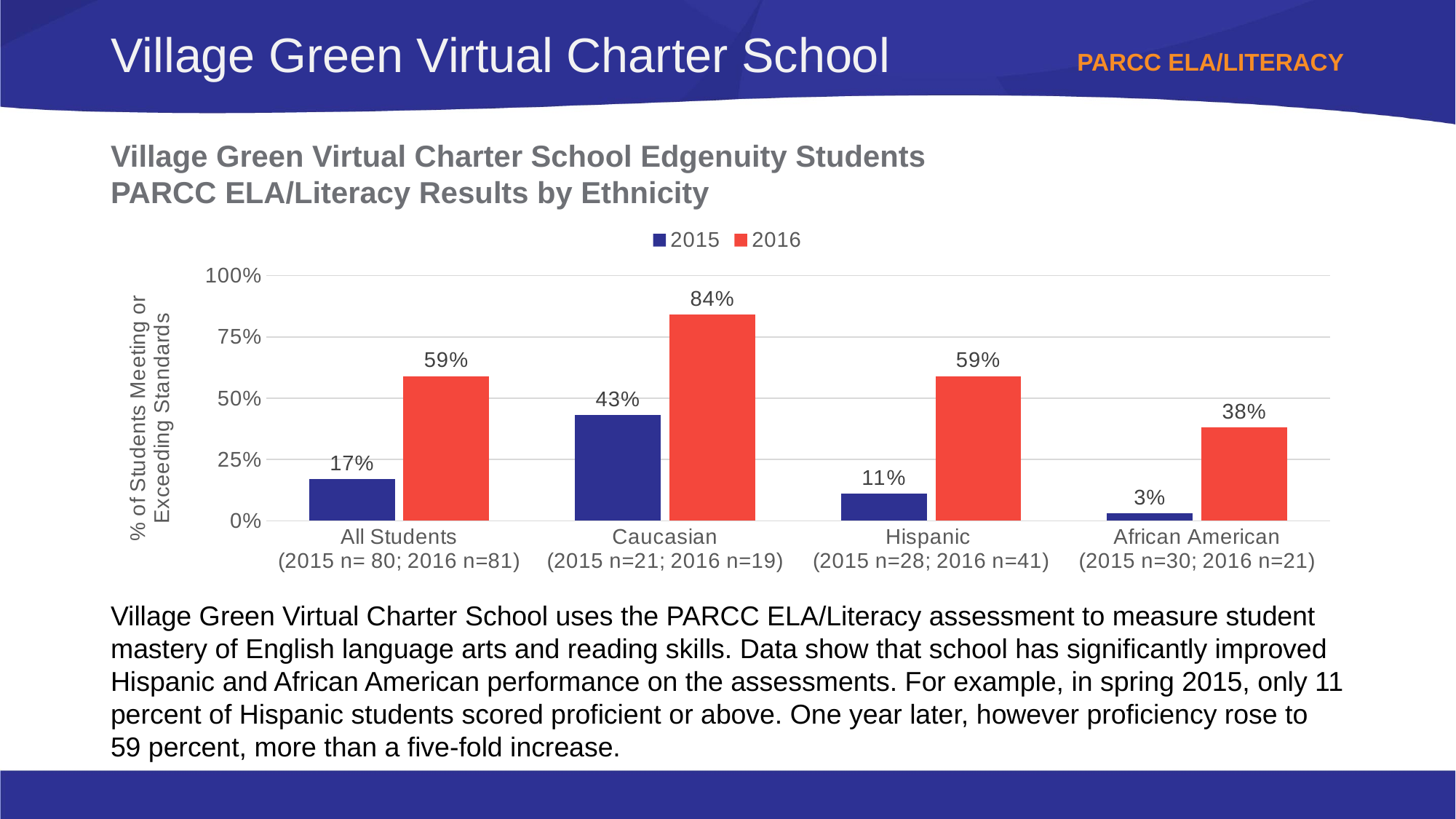
How many series does the legend list? 2 How many ethnicity categories are shown on the x axis? 4 What is the label of the y axis? % of Students Meeting or Exceeding Standards What was the 2016 value for Caucasian students? 84% Which category had the highest 2016 value? Caucasian Which is larger: the 2015 value for Caucasian students or the 2016 value for African American students? 2015 value for Caucasian students What was the 2015 value for Hispanic students? 11% What kind of chart is shown on the slide? Bar chart What is the difference between the 2016 and 2015 values for Hispanic students? 48% What is the difference between the 2016 and 2015 values for All Students? 42% Which category had the lowest 2015 value? African American What was the 2015 value for African American students? 3%